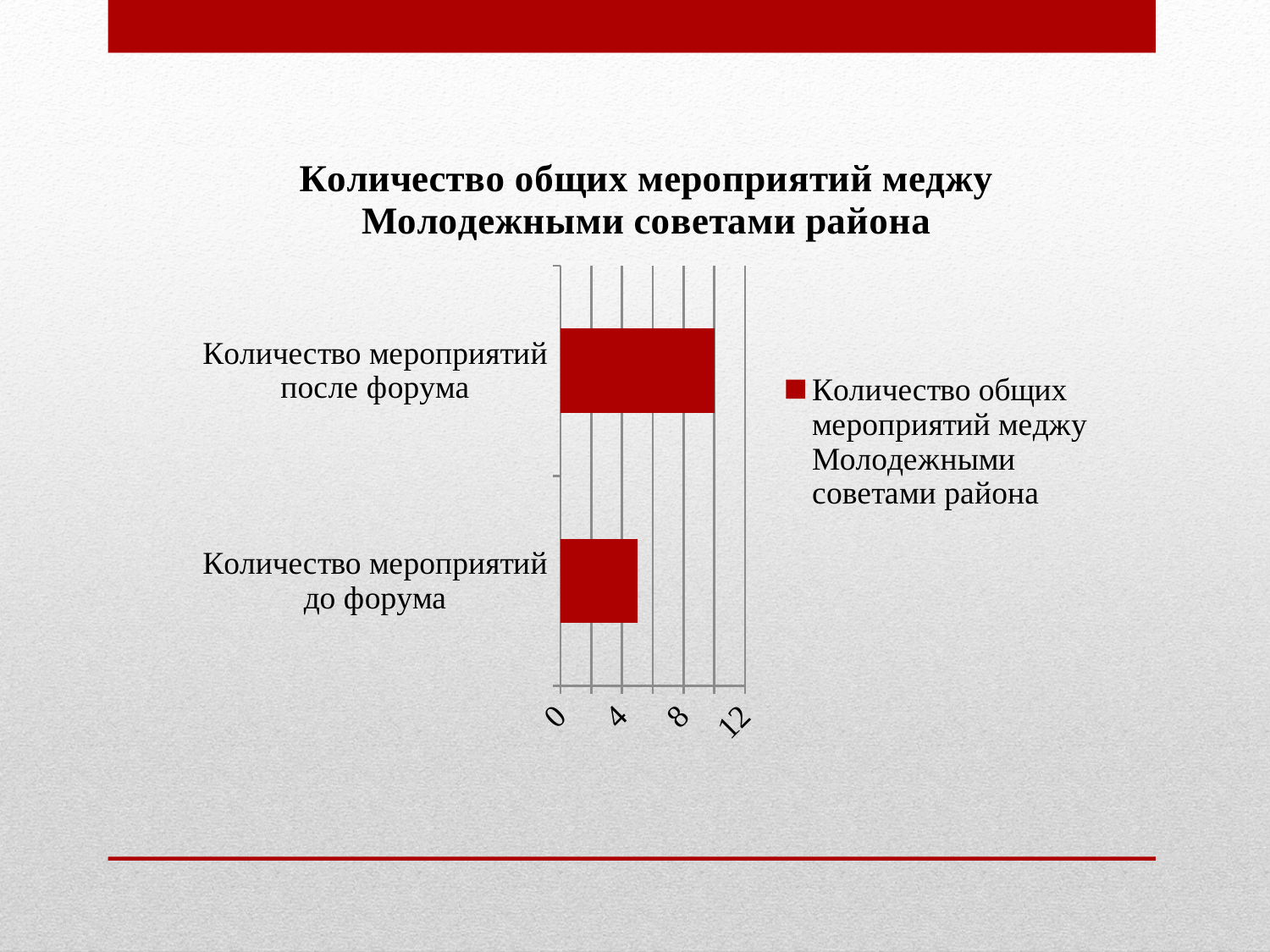
What kind of chart is shown on the slide? Bar chart Which category has the highest value? Количество мероприятий после форума Is the value for "Количество мероприятий после форума" greater or less than 8? greater Is the value for "Количество мероприятий до форума" greater or less than 8? less Is the value for "Количество мероприятий до форума" greater or less than 4? greater What colour are the bars in the chart? Dark red How many categories does the chart show? 2 How many series does the legend list? 1 Which is larger: the value for "Количество мероприятий до форума" or for "Количество мероприятий после форума"? Количество мероприятий после форума What is the title of the chart? Количество общих мероприятий меджу Молодежными советами района Which category has the lowest value? Количество мероприятий до форума